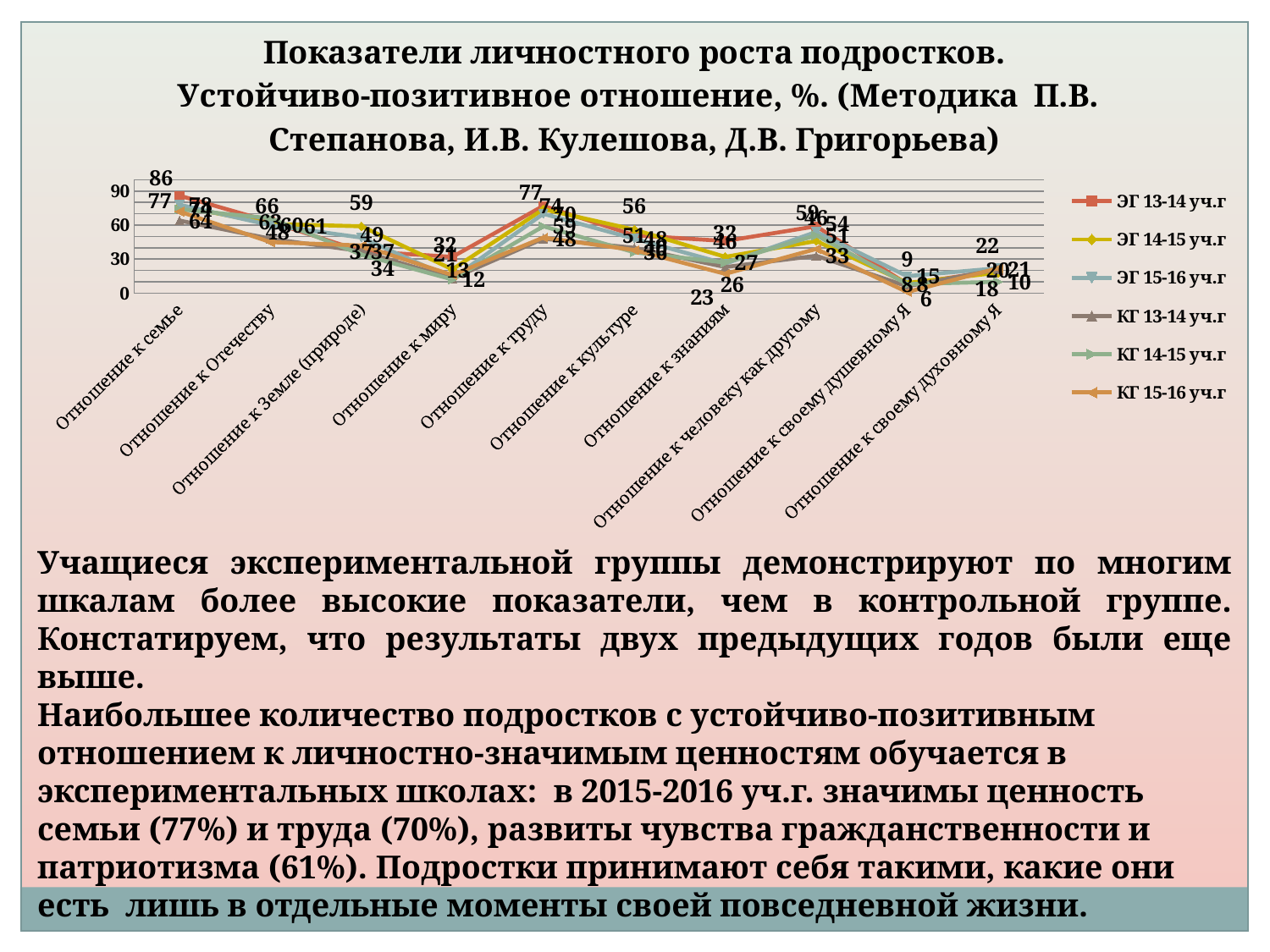
What kind of chart is shown on the slide? line chart For ЭГ 13-14 уч.г, what is the difference between Отношение к семье and Отношение к труду? 9 Is the value for ЭГ 13-14 уч.г for Отношение к семье greater or less than 60? greater How many categories are plotted along the x axis? 10 What is the value for ЭГ 13-14 уч.г for Отношение к труду? 77 What is the value for ЭГ 15-16 уч.г for Отношение к труду? 70 What is the value for ЭГ 13-14 уч.г for Отношение к семье? 86 For ЭГ 13-14 уч.г, which is larger: Отношение к семье or Отношение к своему душевному Я? Отношение к семье Which category has the highest value on the chart? Отношение к семье What is the value for ЭГ 15-16 уч.г for Отношение к семье? 78 Which category has the lowest value on the chart? Отношение к своему душевному Я How many series does the legend list? 6